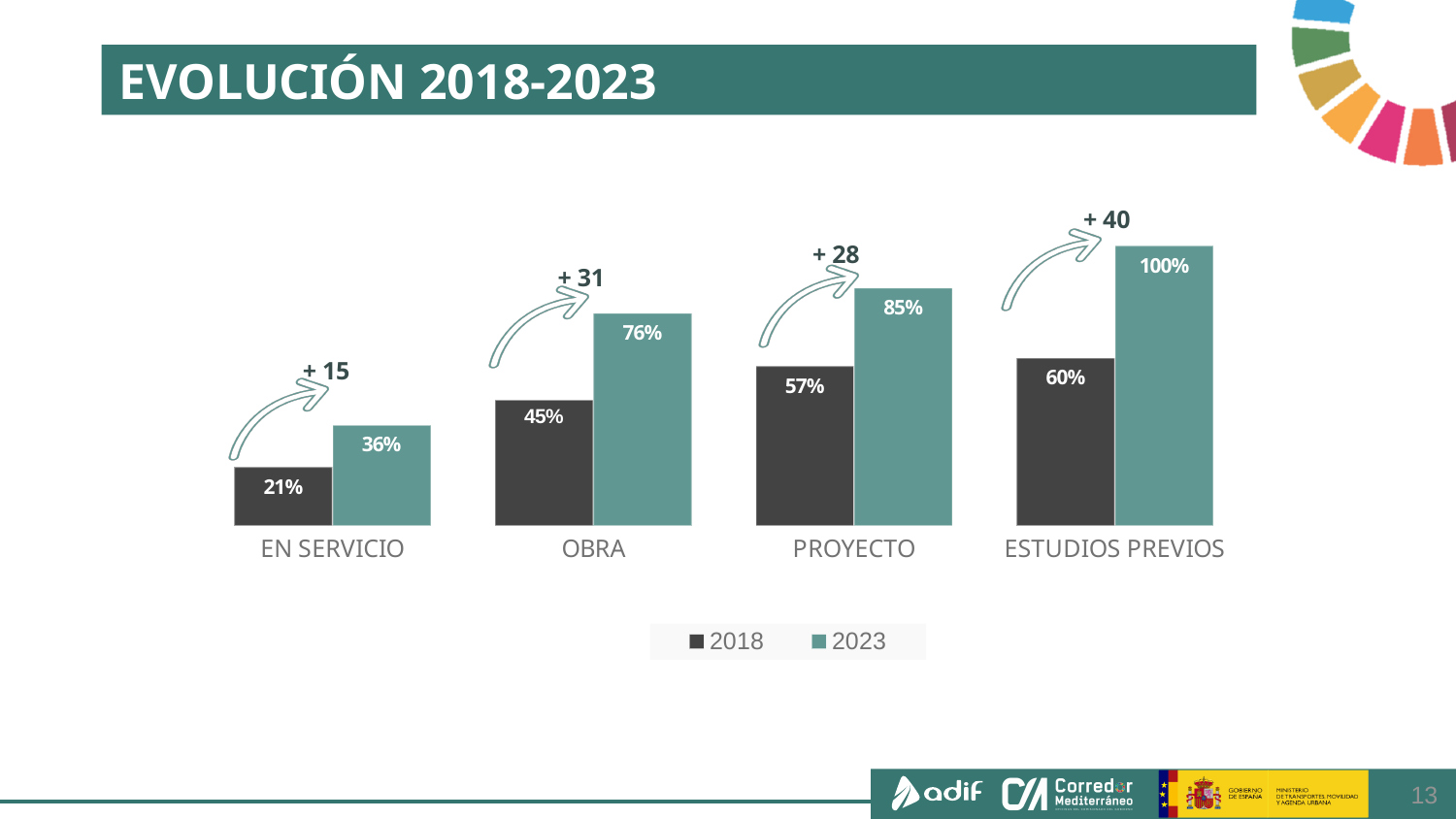
What is the 2018 value for EN SERVICIO? 21% Which category has the lowest 2018 value? EN SERVICIO What is the title of the slide? EVOLUCIÓN 2018-2023 What is the 2023 value for OBRA? 76% What is the 2018 value for PROYECTO? 57% Which is larger: the 2023 value for EN SERVICIO or the 2018 value for OBRA? 2018 value for OBRA What is the 2023 value for ESTUDIOS PREVIOS? 100% What is the difference between the 2023 and 2018 values for PROYECTO? 28 What kind of chart is shown on the slide? Bar chart How many categories are shown on the x axis? 4 How many series does the legend list? 2 Which category has the highest 2023 value? ESTUDIOS PREVIOS